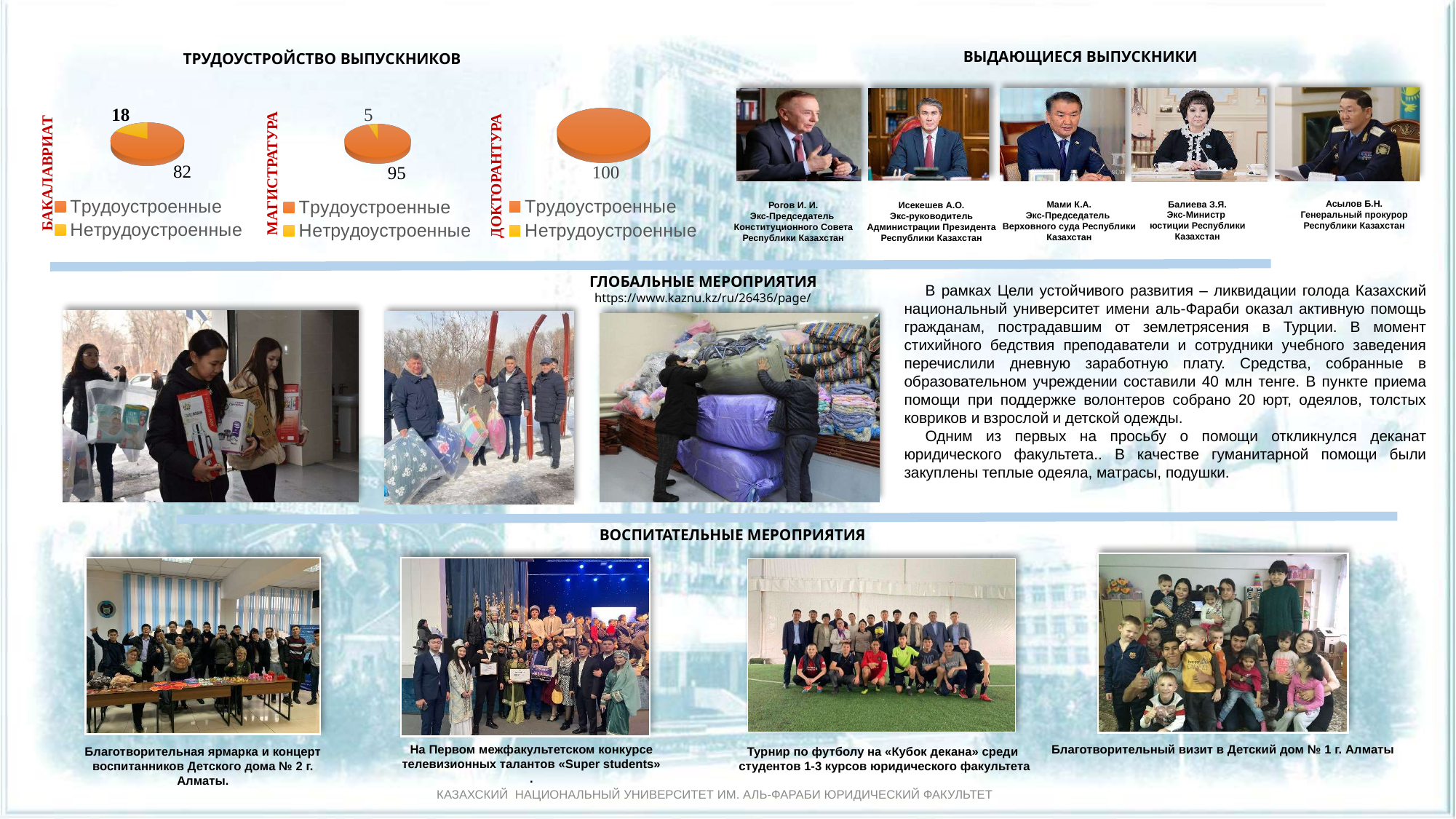
How many entries does the legend of the Бакалавриат pie chart list? 2 Which chart has the larger value for Нетрудоустроенные: Бакалавриат or Магистратура? Бакалавриат In the Магистратура pie chart, what is the difference between Трудоустроенные and Нетрудоустроенные? 90 In the Бакалавриат pie chart, which is larger: Трудоустроенные or Нетрудоустроенные? Трудоустроенные In the Магистратура pie chart, what is the value for Трудоустроенные? 95 In the Магистратура pie chart, what is the value for Нетрудоустроенные? 5 In the Бакалавриат pie chart, what is the difference between Трудоустроенные and Нетрудоустроенные? 64 In the Бакалавриат pie chart, what is the value for Нетрудоустроенные? 18 In the Бакалавриат pie chart, what is the value for Трудоустроенные? 82 What kind of chart is used in the Трудоустройство выпускников section? Pie chart How many pie charts are shown in the Трудоустройство выпускников section? 3 In the Докторантура pie chart, what is the value for Трудоустроенные? 100